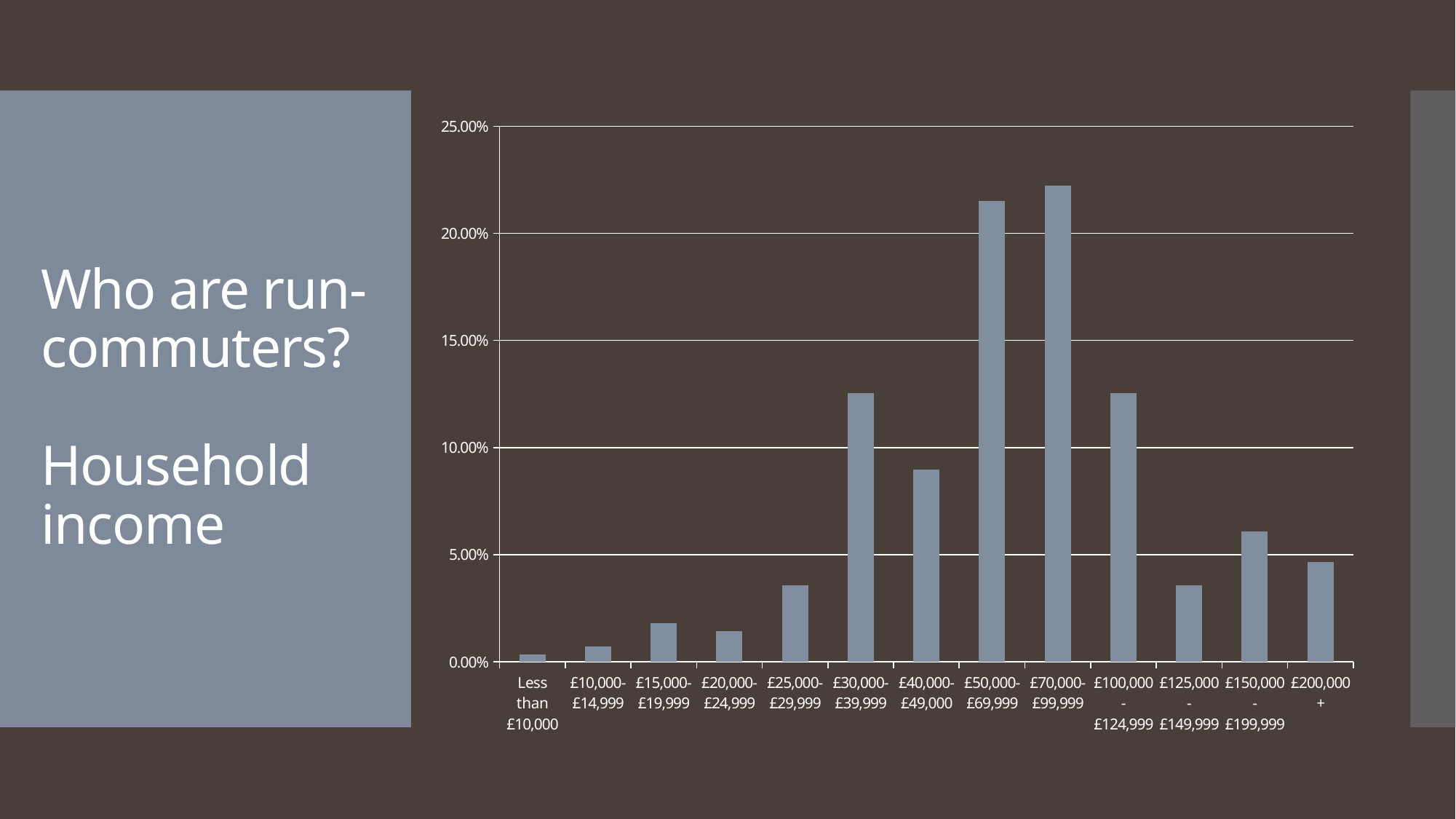
Is the value for £30,000-£39,999 greater or less than 10.00%? greater Is the value for £40,000-£49,000 greater or less than 10.00%? less What kind of chart is shown on the slide? bar chart Which is larger, the value for £150,000-£199,999 or the value for £200,000+? £150,000-£199,999 What is the highest value shown on the y axis? 25.00% Which is larger, the value for £30,000-£39,999 or the value for £40,000-£49,000? £30,000-£39,999 How many household income categories are shown on the x axis? 13 Is the value for £150,000-£199,999 greater or less than 5.00%? greater Which household income category has the lowest value? Less than £10,000 Which household income category has the highest value? £70,000-£99,999